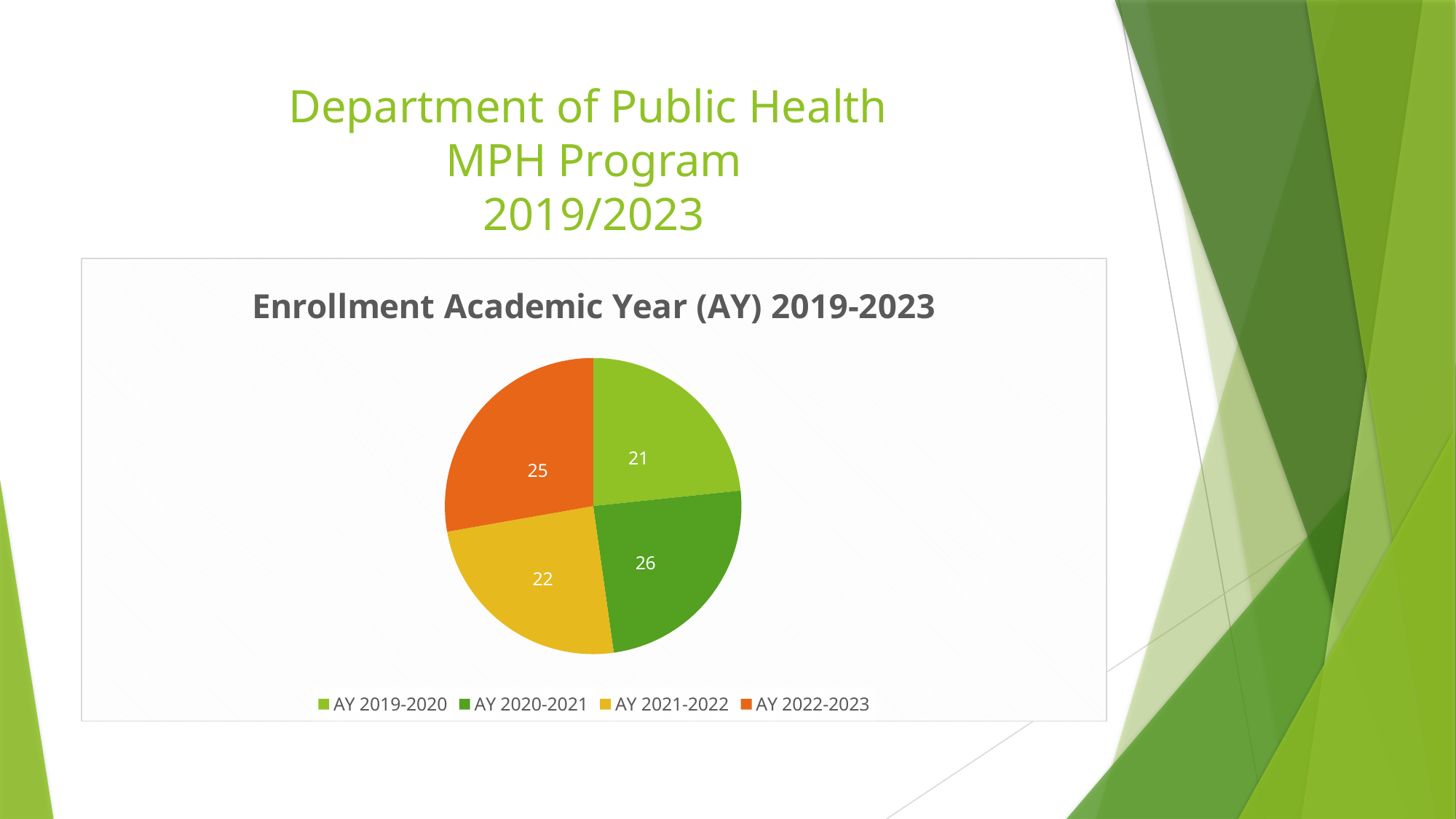
Which academic year has the lowest enrollment? AY 2019-2020 What is the difference in enrollment between AY 2020-2021 and AY 2019-2020? 5 What is the enrollment value for AY 2022-2023? 25 What is the enrollment value for AY 2019-2020? 21 Which academic year has the highest enrollment? AY 2020-2021 What is the total enrollment across all four academic years shown? 94 What type of chart is shown on the slide? Pie chart What is the title of the chart? Enrollment Academic Year (AY) 2019-2023 What is the enrollment value for AY 2021-2022? 22 Which has a larger enrollment, AY 2022-2023 or AY 2021-2022? AY 2022-2023 What is the enrollment value for AY 2020-2021? 26 How many academic years are shown in the pie chart? 4